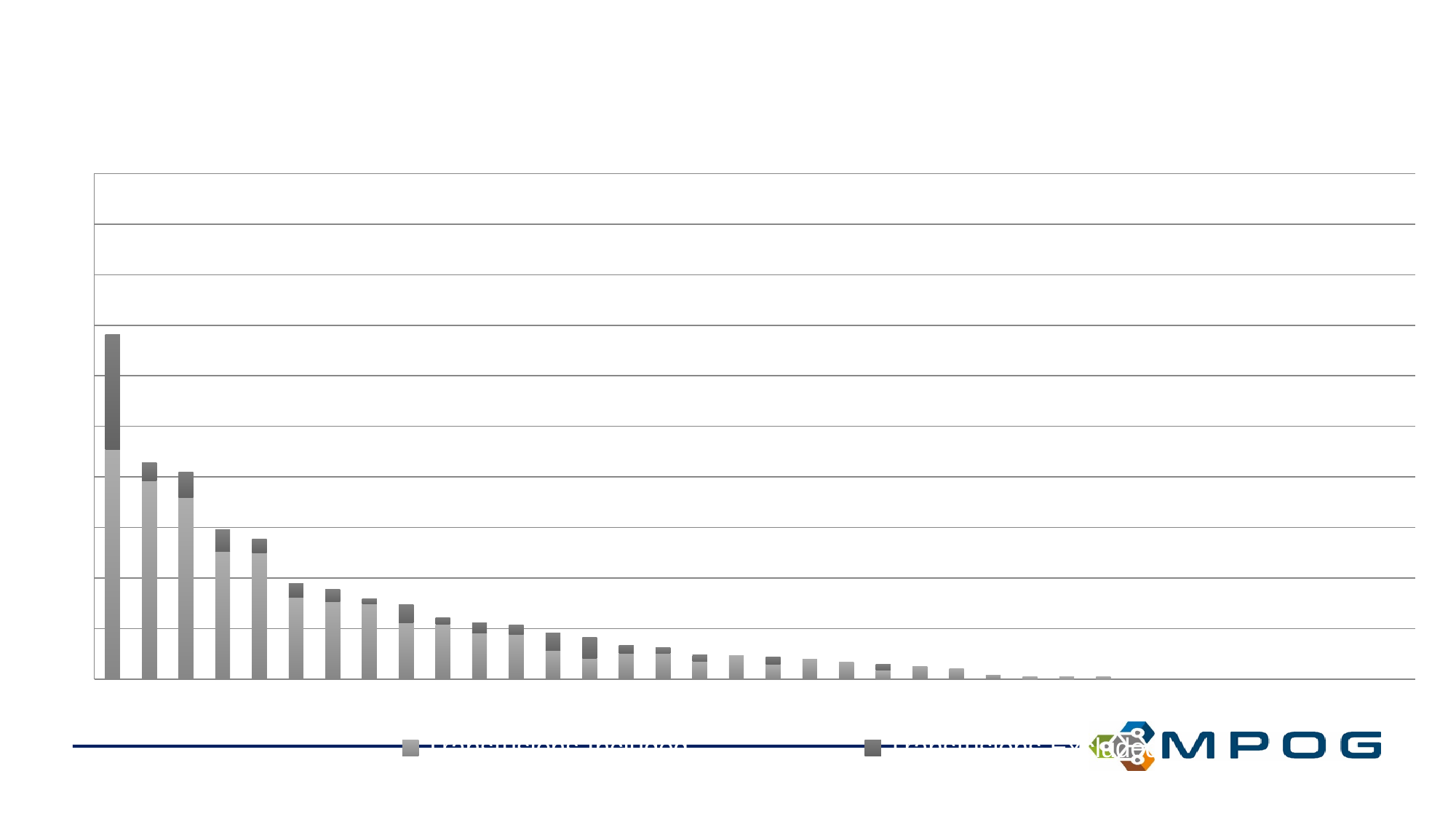
Which segment sits on top of each stacked bar, the light grey or the dark grey one? Dark grey Do the bar heights rise or fall from left to right along the x axis? Fall Which is taller, the leftmost bar or the second bar from the left? The leftmost bar What kind of chart is shown on the slide? Stacked bar chart How many series does the legend list? 2 Which bar is the tallest in the chart? The leftmost bar How many bars are plotted in the chart? 28 What two colours are used for the stacked segments of the bars? Light grey and dark grey